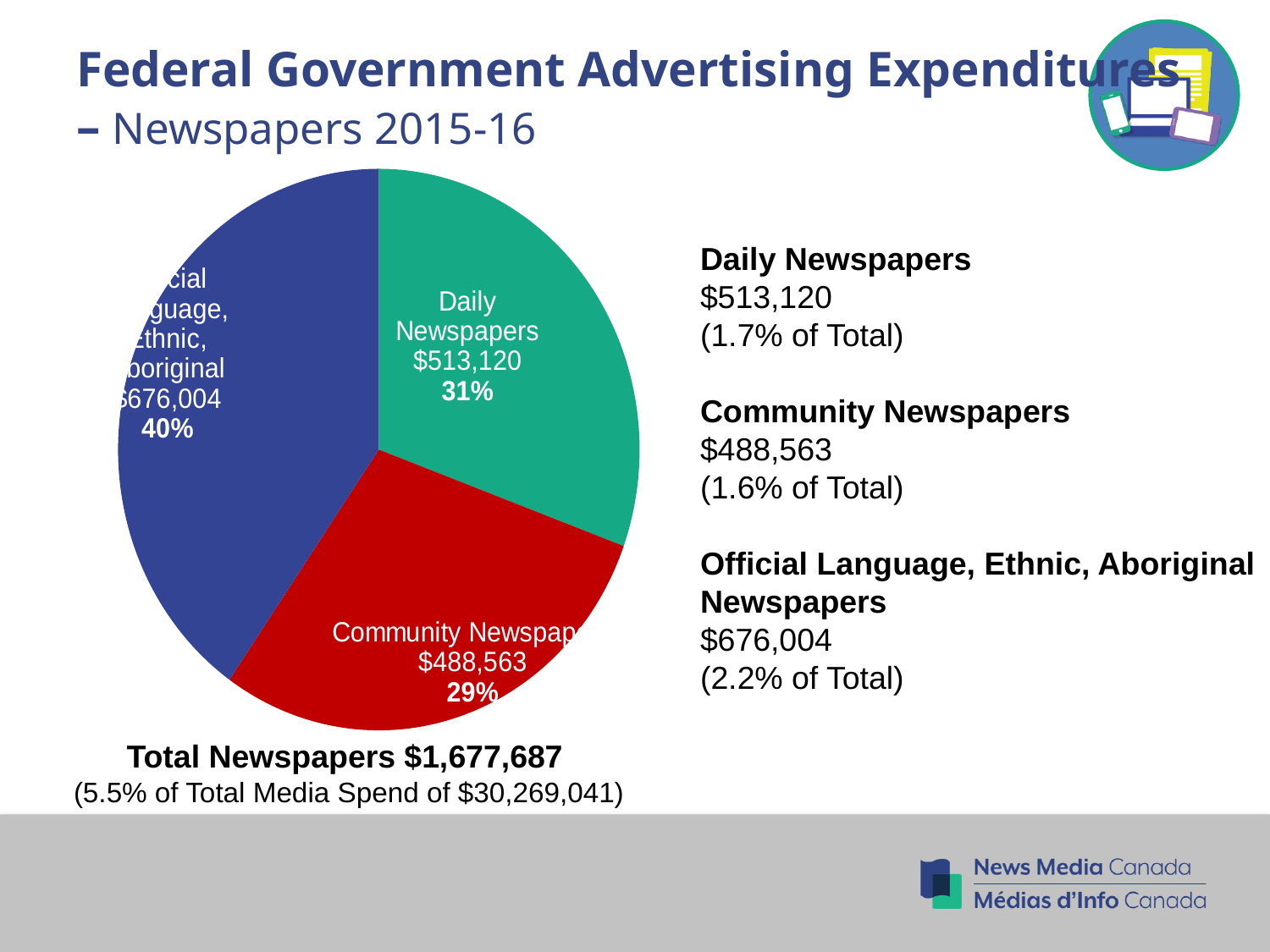
What share of the pie does Daily Newspapers represent? 31% What is the value for Daily Newspapers? $513,120 What is the value for Community Newspapers? $488,563 What is the difference between the Official Language, Ethnic, Aboriginal Newspapers value and the Daily Newspapers value? $162,884 Which is larger, the value for Daily Newspapers or the value for Community Newspapers? Daily Newspapers What kind of chart is shown on the slide? Pie chart Which category has the smallest slice of the pie? Community Newspapers What share of the pie does Official Language, Ethnic, Aboriginal Newspapers represent? 40% How many slices does the pie chart have? 3 What colour is the Community Newspapers slice? Red Which category has the largest slice of the pie? Official Language, Ethnic, Aboriginal Newspapers What is the value for Official Language, Ethnic, Aboriginal Newspapers? $676,004